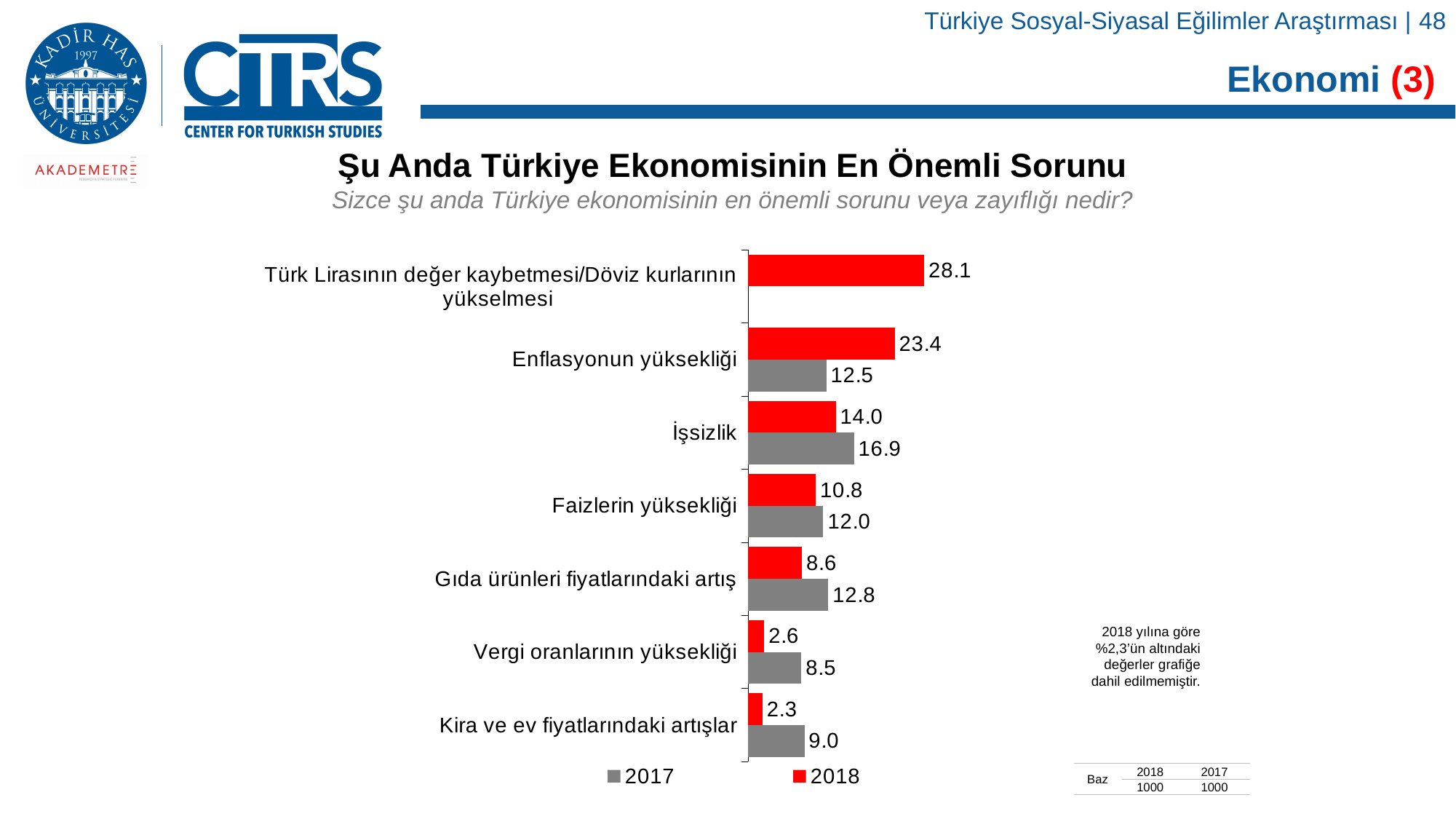
What is the 2018 value for "Türk Lirasının değer kaybetmesi/Döviz kurlarının yükselmesi"? 28.1 What is the difference between the 2017 and 2018 values for "Kira ve ev fiyatlarındaki artışlar"? 6.7 Which category has the highest 2018 value? Türk Lirasının değer kaybetmesi/Döviz kurlarının yükselmesi What is the 2017 value for "İşsizlik"? 16.9 Which colour represents the 2018 series in the chart? Red Which category has the lowest 2017 value? Vergi oranlarının yüksekliği How many categories are shown in the chart? 7 How many series does the legend list? 2 Which is larger for "Gıda ürünleri fiyatlarındaki artış": the 2017 value or the 2018 value? 2017 What is the difference between the 2018 and 2017 values for "Enflasyonun yüksekliği"? 10.9 What is the 2018 value for "Enflasyonun yüksekliği"? 23.4 What kind of chart is shown on the slide? Bar chart